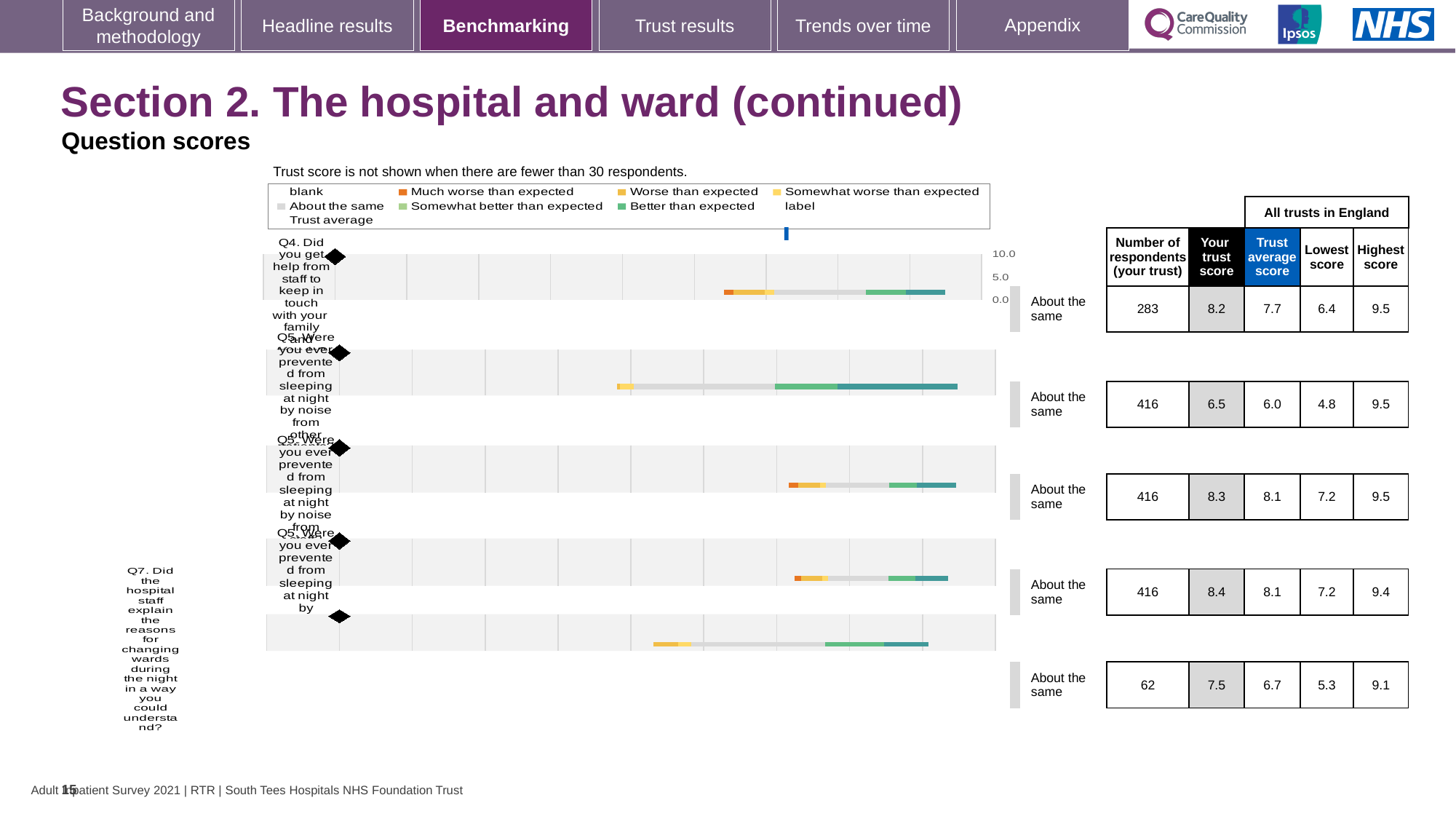
How many respondents answered Q4 (help from staff to keep in touch with family)? 283 What kind of chart is used to show the question scores on this slide? bar chart What is the lowest 'Your trust score' shown in the table? 6.5 What is the 'Your trust score' for Q7 (explaining reasons for changing wards during the night)? 7.5 How many respondents answered Q7 (explaining reasons for changing wards during the night)? 62 What is the highest score across all trusts in England for Q7 (explaining reasons for changing wards during the night)? 9.1 What is the trust average score for Q4 (help from staff to keep in touch with family)? 7.7 What is the difference between the trust score and the trust average score for Q4? 0.5 Which has the higher trust score, Q4 or Q7? Q4 What benchmark category is shown for Q4 (help from staff to keep in touch with family)? About the same How many question rows are plotted in the chart? 5 What is the 'Your trust score' for Q4 (help from staff to keep in touch with family)? 8.2